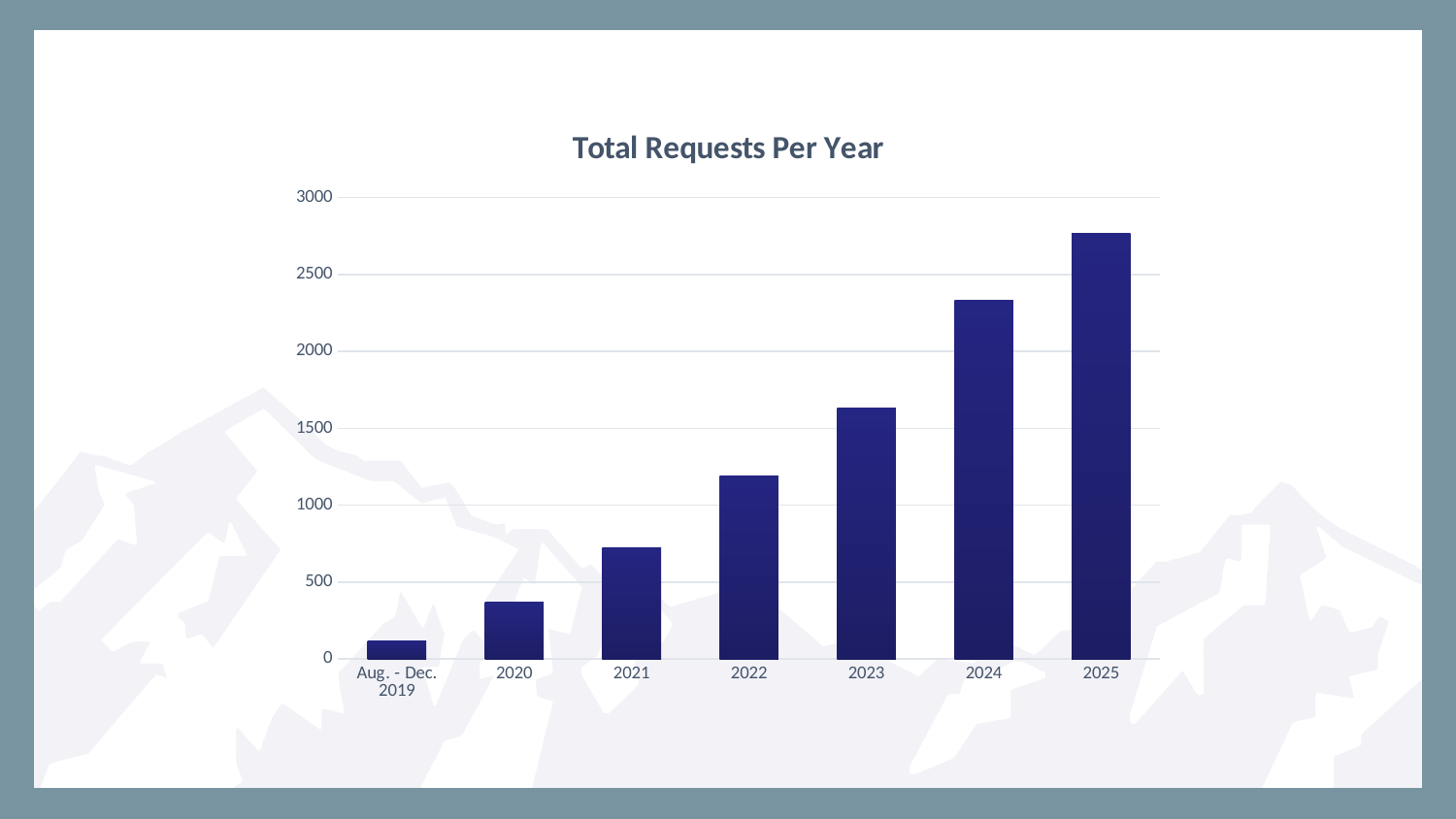
Is the value for 2021 greater or less than 1000? less What is the title of the chart? Total Requests Per Year Is the value for 2023 greater or less than 1500? greater Which category has the highest value in the chart? 2025 Which is larger, the value for 2023 or the value for 2024? 2024 Is the value for 2020 greater or less than 500? less Do the values rise or fall from left to right along the x axis? rise Which category has the lowest value in the chart? Aug. - Dec. 2019 How many categories are shown on the x axis of the chart? 7 What kind of chart is shown on the slide? bar chart